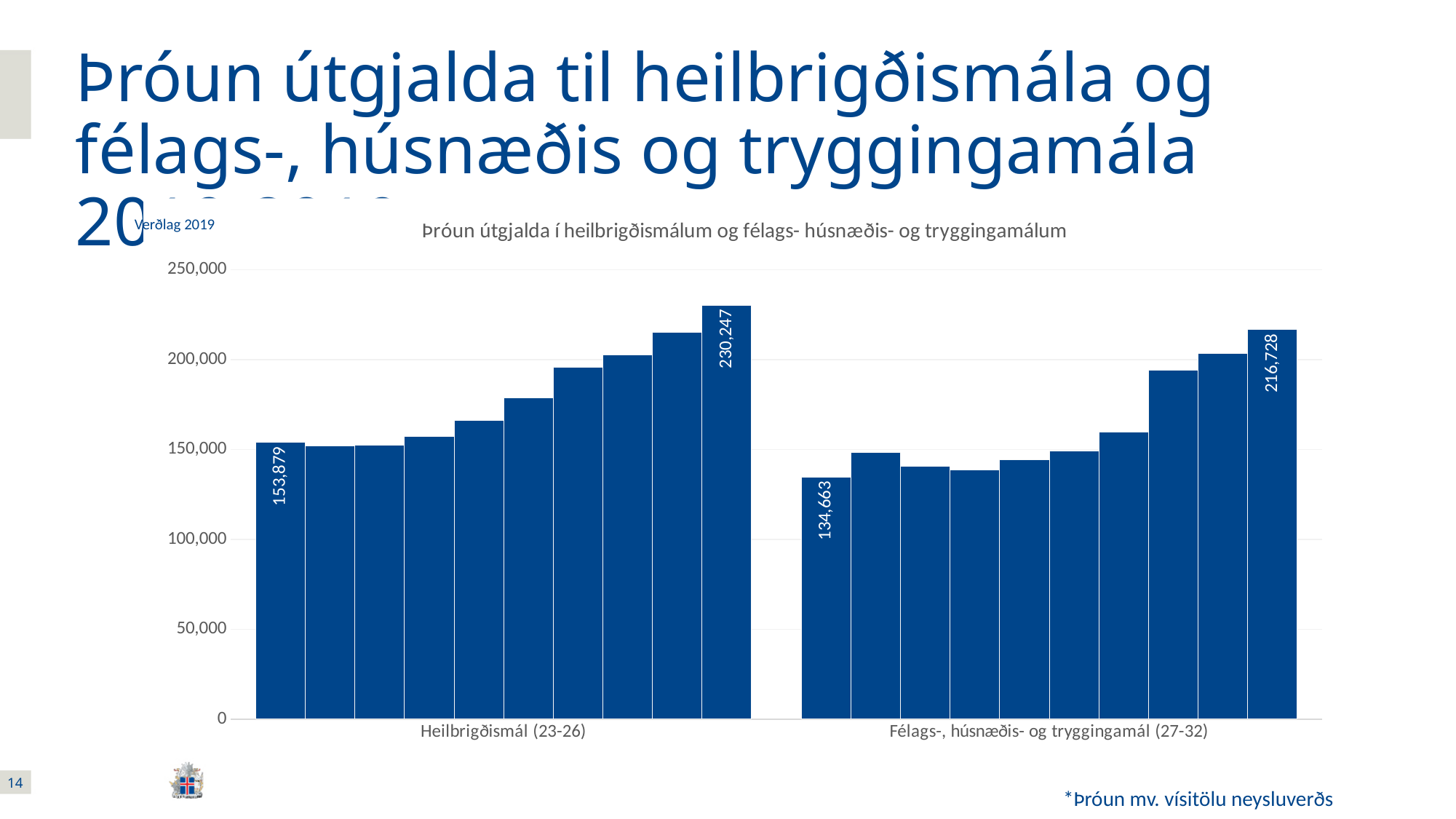
What is the difference between the first bar of the Heilbrigðismál (23-26) group and the first bar of the Félags-, húsnæðis- og tryggingamál (27-32) group? 19,216 Is the value of the first bar in the Félags-, húsnæðis- og tryggingamál (27-32) group greater or less than 150,000? less By how much does the last bar in the Félags-, húsnæðis- og tryggingamál (27-32) group exceed the first bar in that group? 82,065 What is the value of the first (leftmost) bar in the Félags-, húsnæðis- og tryggingamál (27-32) group? 134,663 Do the values in the Heilbrigðismál (23-26) group generally rise or fall from left to right? rise How many bars are in the Heilbrigðismál (23-26) group? 10 Which is larger: the last bar of the Heilbrigðismál (23-26) group or the last bar of the Félags-, húsnæðis- og tryggingamál (27-32) group? Heilbrigðismál (23-26) What is the value of the last (rightmost) bar in the Félags-, húsnæðis- og tryggingamál (27-32) group? 216,728 By how much does the last bar in the Heilbrigðismál (23-26) group exceed the first bar in that group? 76,368 What kind of chart is shown on the slide? bar chart What is the value of the first (leftmost) bar in the Heilbrigðismál (23-26) group? 153,879 What is the value of the last (rightmost) bar in the Heilbrigðismál (23-26) group? 230,247